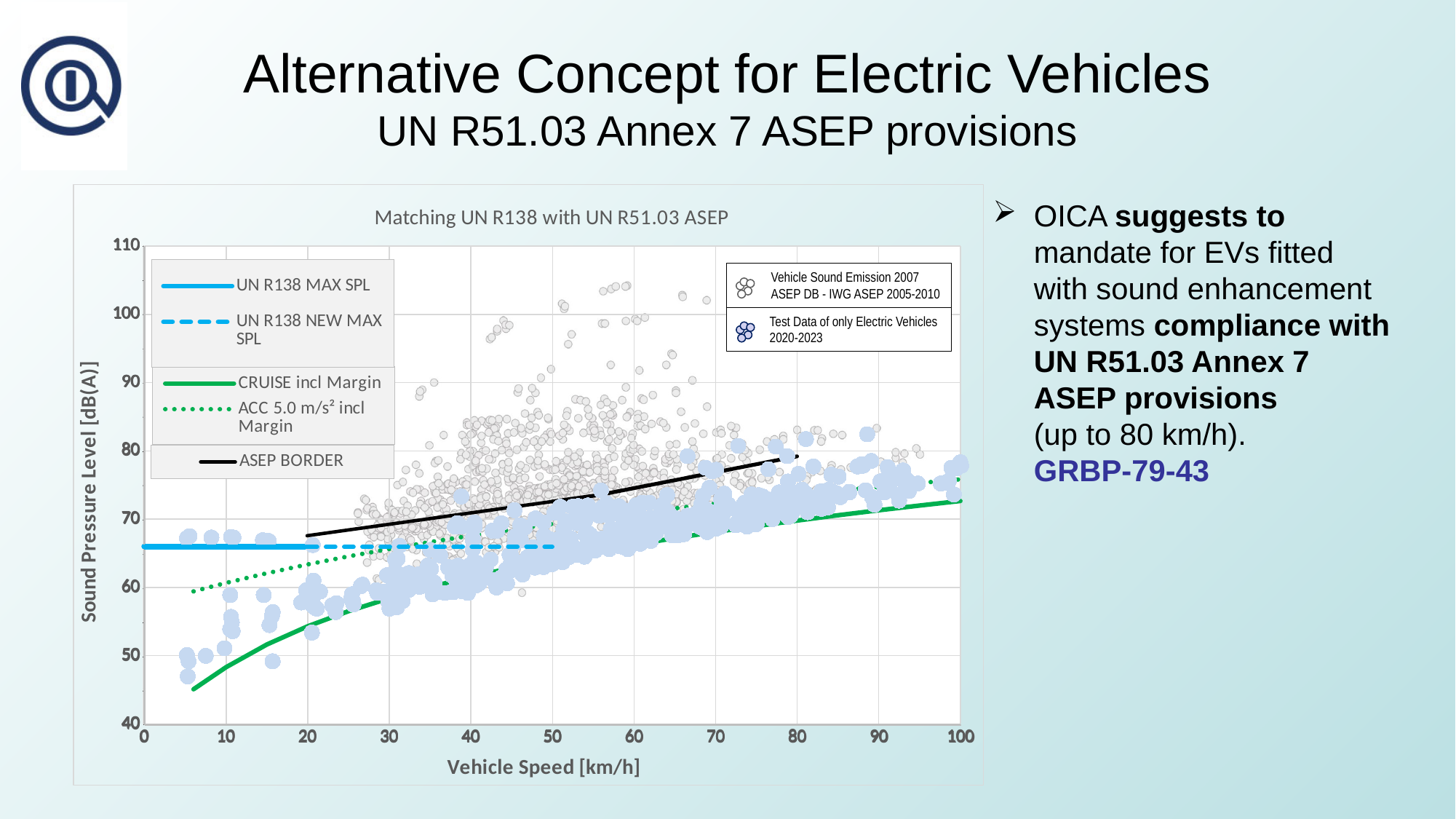
Is the value of the CRUISE incl Margin line at 100 km/h greater or less than 80 dB(A)? less How many series does the main legend of the chart list? 5 Is the value of the CRUISE incl Margin line at 100 km/h greater or less than 70 dB(A)? greater Is the value of the UN R138 MAX SPL line greater or less than 60 dB(A)? greater Does the ASEP BORDER line rise or fall as vehicle speed increases? rises What kind of chart is shown on the slide? scatter chart At 100 km/h, which is higher: the ACC 5.0 m/s² incl Margin line or the CRUISE incl Margin line? ACC 5.0 m/s² incl Margin What is the label of the x axis of the chart? Vehicle Speed [km/h] What is the title of the chart? Matching UN R138 with UN R51.03 ASEP At 50 km/h, which is higher: the ASEP BORDER line or the UN R138 NEW MAX SPL line? ASEP BORDER